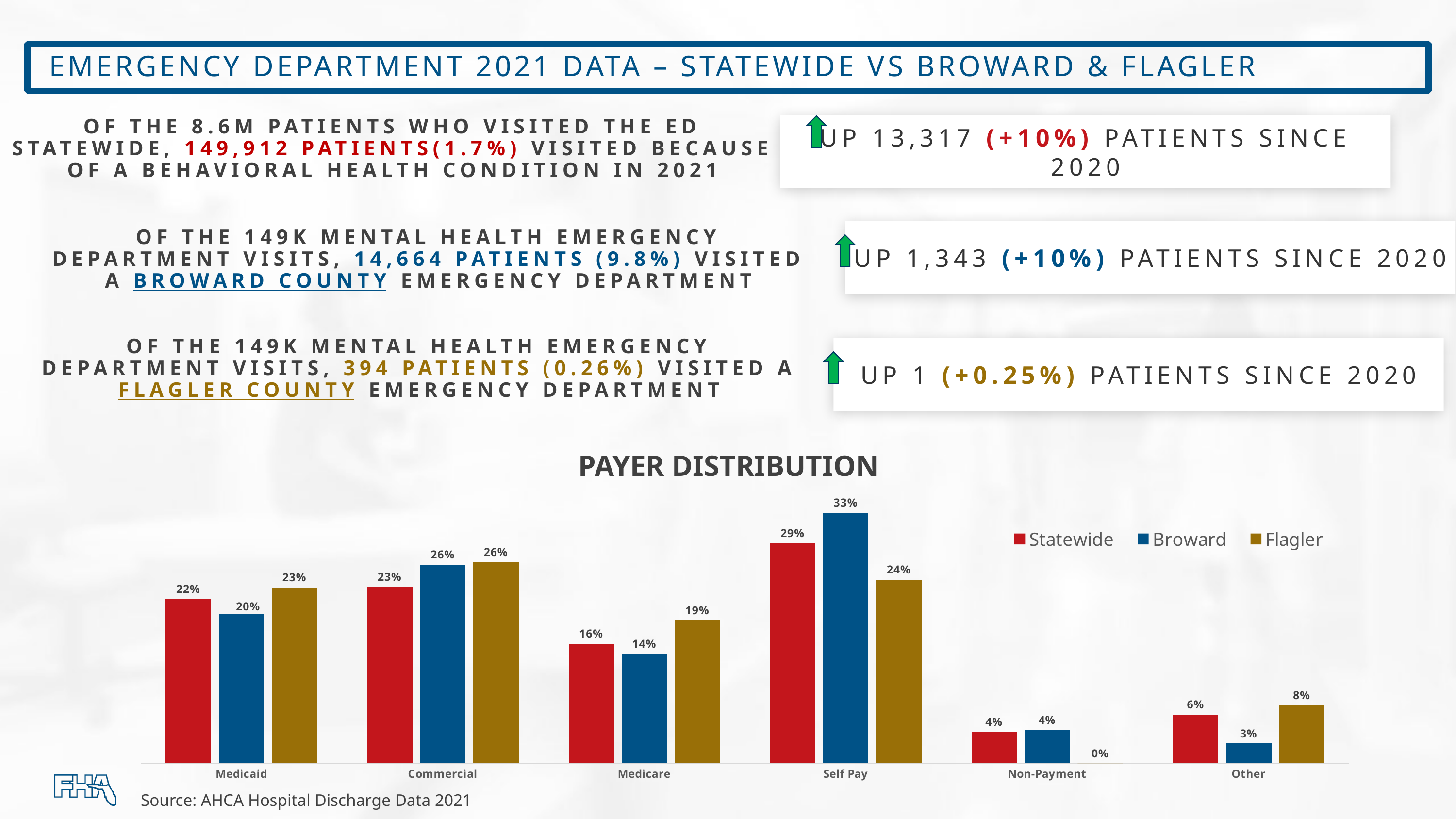
Which payer category has the highest Broward value in the Payer Distribution chart? Self Pay What is the Statewide value for Self Pay in the Payer Distribution chart? 29% What is the difference between the Broward and Statewide values for Self Pay in the Payer Distribution chart? 4% Which series is shown in gold in the Payer Distribution chart? Flagler Which payer category has the lowest Flagler value in the Payer Distribution chart? Non-Payment What is the Flagler value for Medicare in the Payer Distribution chart? 19% What type of chart is the Payer Distribution chart? Bar chart Which is larger for Medicaid in the Payer Distribution chart: the Statewide value or the Broward value? Statewide What is the Broward value for Other in the Payer Distribution chart? 3% What is the difference between the Flagler and Broward values for Other in the Payer Distribution chart? 5% How many series does the legend of the Payer Distribution chart list? 3 How many payer categories are shown on the x axis of the Payer Distribution chart? 6